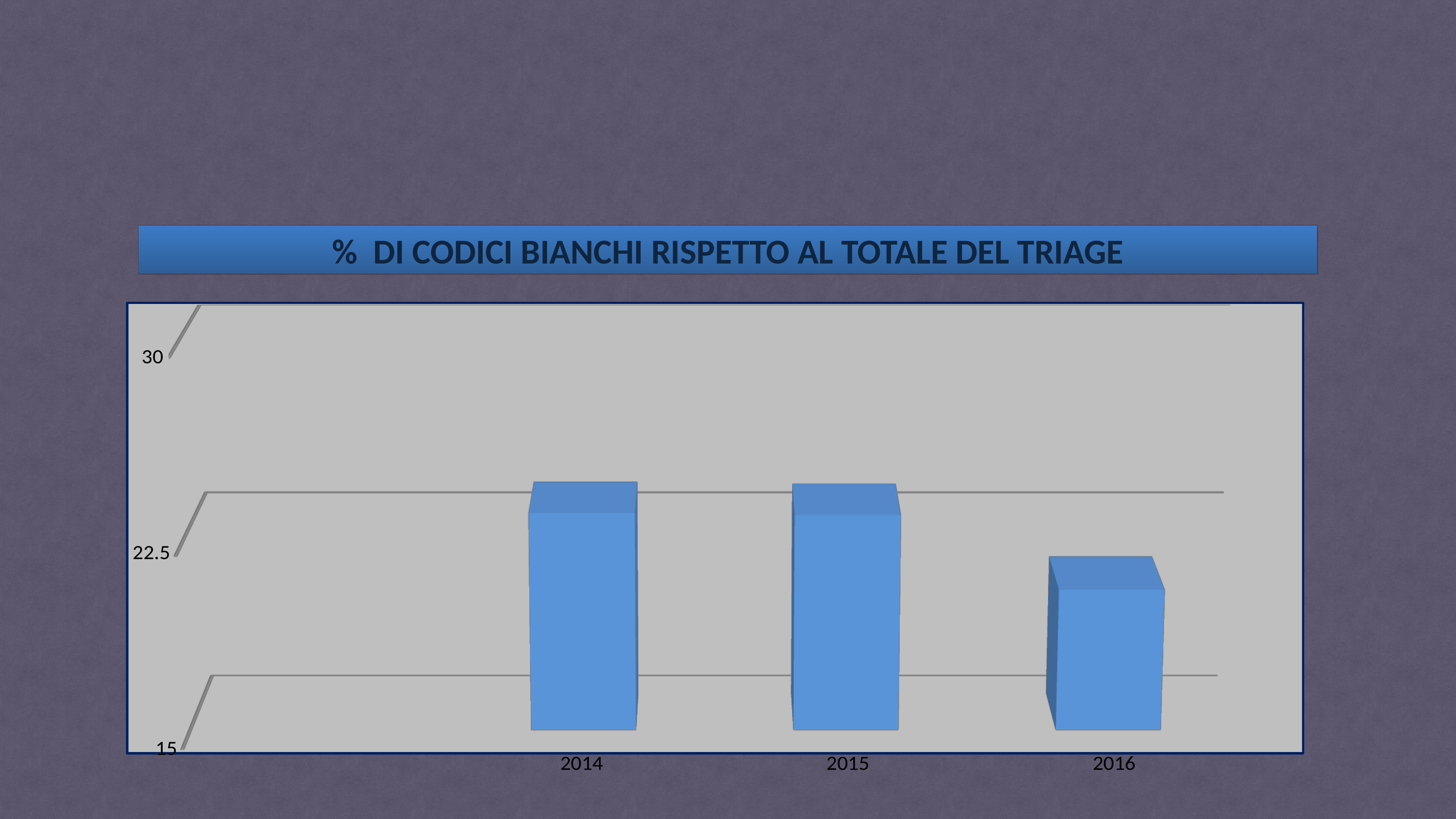
How many years are shown on the x axis of the chart? 3 Is the value for 2016 greater or less than 15? greater Is the value for 2016 greater or less than 22.5? less Which year has the lowest value in the chart? 2016 What is the title of the chart? % DI CODICI BIANCHI RISPETTO AL TOTALE DEL TRIAGE Which is larger, the value for 2015 or the value for 2016? 2015 Do the values rise or fall from 2014 to 2016? fall Is the value for 2014 greater or less than 30? less Which is larger, the value for 2014 or the value for 2016? 2014 What kind of chart is shown on the slide? bar chart What is the highest tick value shown on the vertical axis? 30